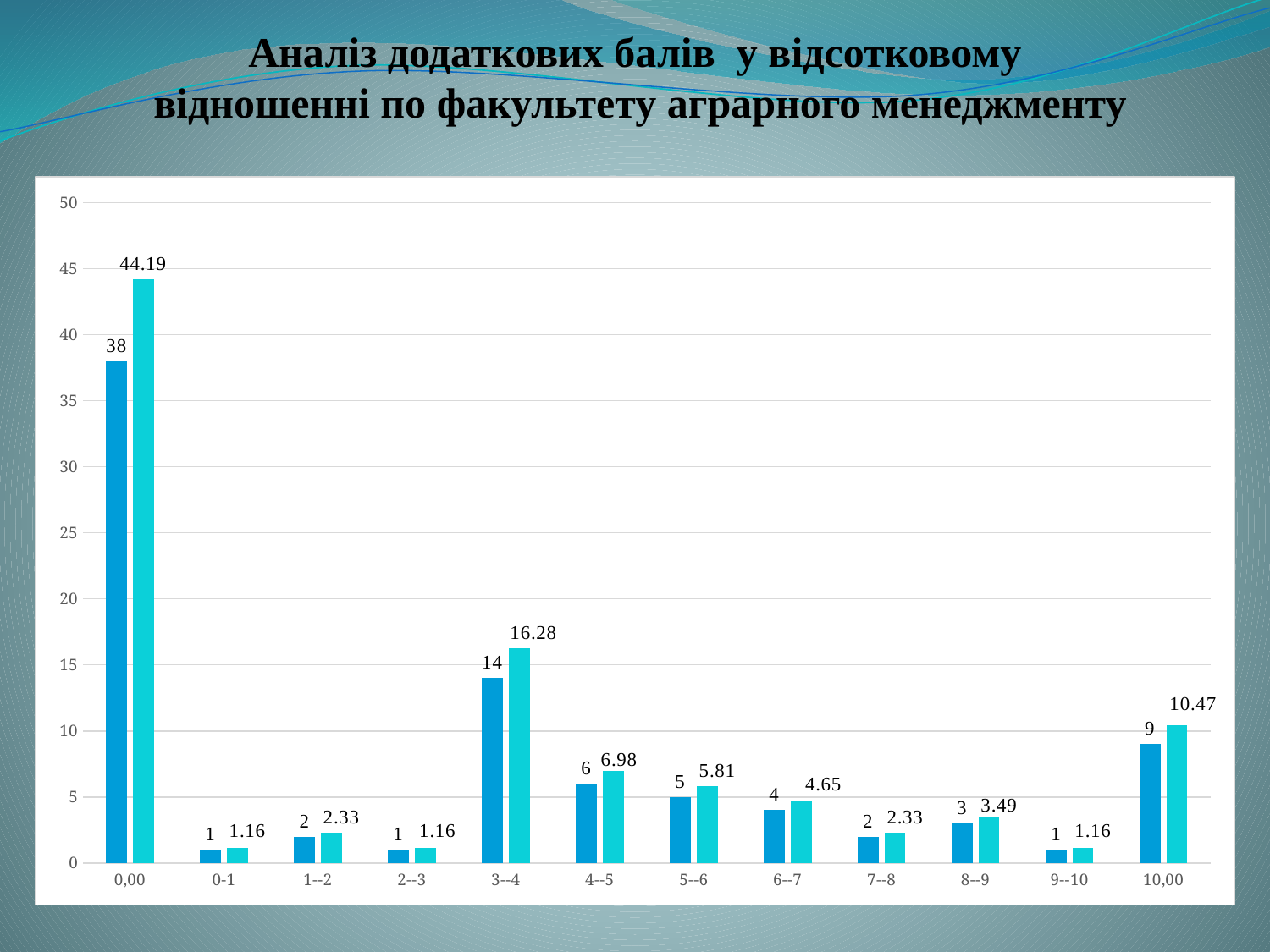
Which category has the lowest dark blue bar among 3--4, 4--5 and 10,00? 4--5 What is the value of the dark blue bar for the category 0,00? 38 Which category has the highest light blue (cyan) bar? 0,00 What kind of chart is shown on the slide? Bar chart Is the light blue (cyan) bar for 0,00 greater or less than 40? greater What is the value of the light blue (cyan) bar for the category 3--4? 16.28 What is the value of the light blue (cyan) bar for the category 10,00? 10.47 What is the highest value shown on the vertical axis? 50 How many categories are shown on the x axis? 12 Which is larger: the dark blue bar for 6--7 or the dark blue bar for 8--9? 6--7 What is the value of the dark blue bar for the category 5--6? 5 What is the difference between the light blue (cyan) bar values for 0,00 and 3--4? 27.91